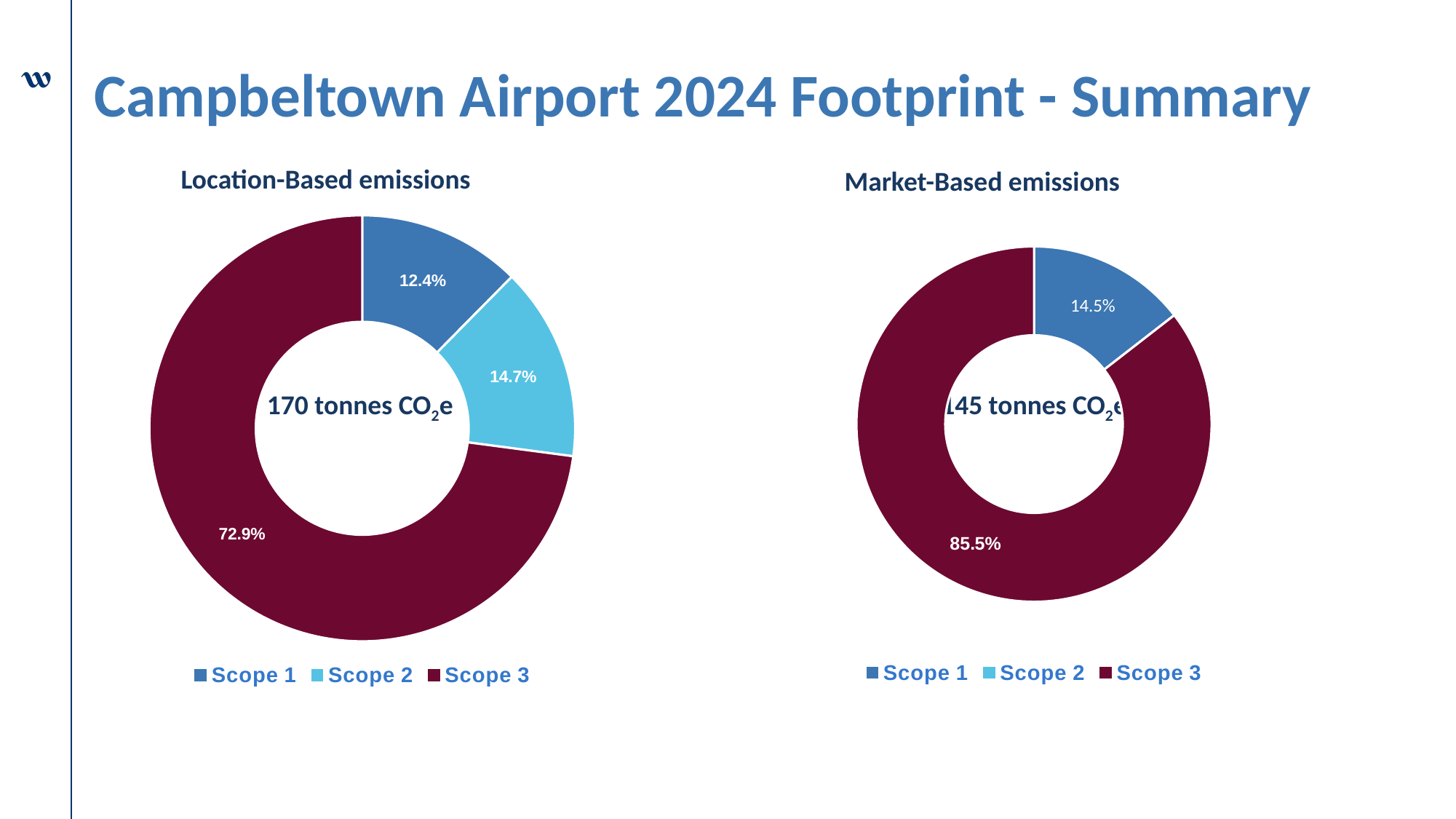
How many entries does the legend of the Market-Based emissions chart list? 3 In the Location-Based emissions chart, what share of emissions is Scope 3? 72.9% In the Location-Based emissions chart, what share of emissions is Scope 2? 14.7% In the Market-Based emissions chart, what share of emissions is Scope 1? 14.5% In the Market-Based emissions chart, what is the difference in percentage points between Scope 3 and Scope 1? 71 In the Location-Based emissions chart, what is the difference in percentage points between Scope 3 and Scope 2? 58.2 Which is larger in the Location-Based emissions chart: the Scope 1 share or the Scope 2 share? Scope 2 In the Location-Based emissions chart, what share of emissions is Scope 1? 12.4% In the Market-Based emissions chart, what share of emissions is Scope 3? 85.5% In the Location-Based emissions chart, which scope has the largest share? Scope 3 What type of chart is the Location-Based emissions chart? Donut (pie) chart In the Location-Based emissions chart, which scope has the smallest share? Scope 1